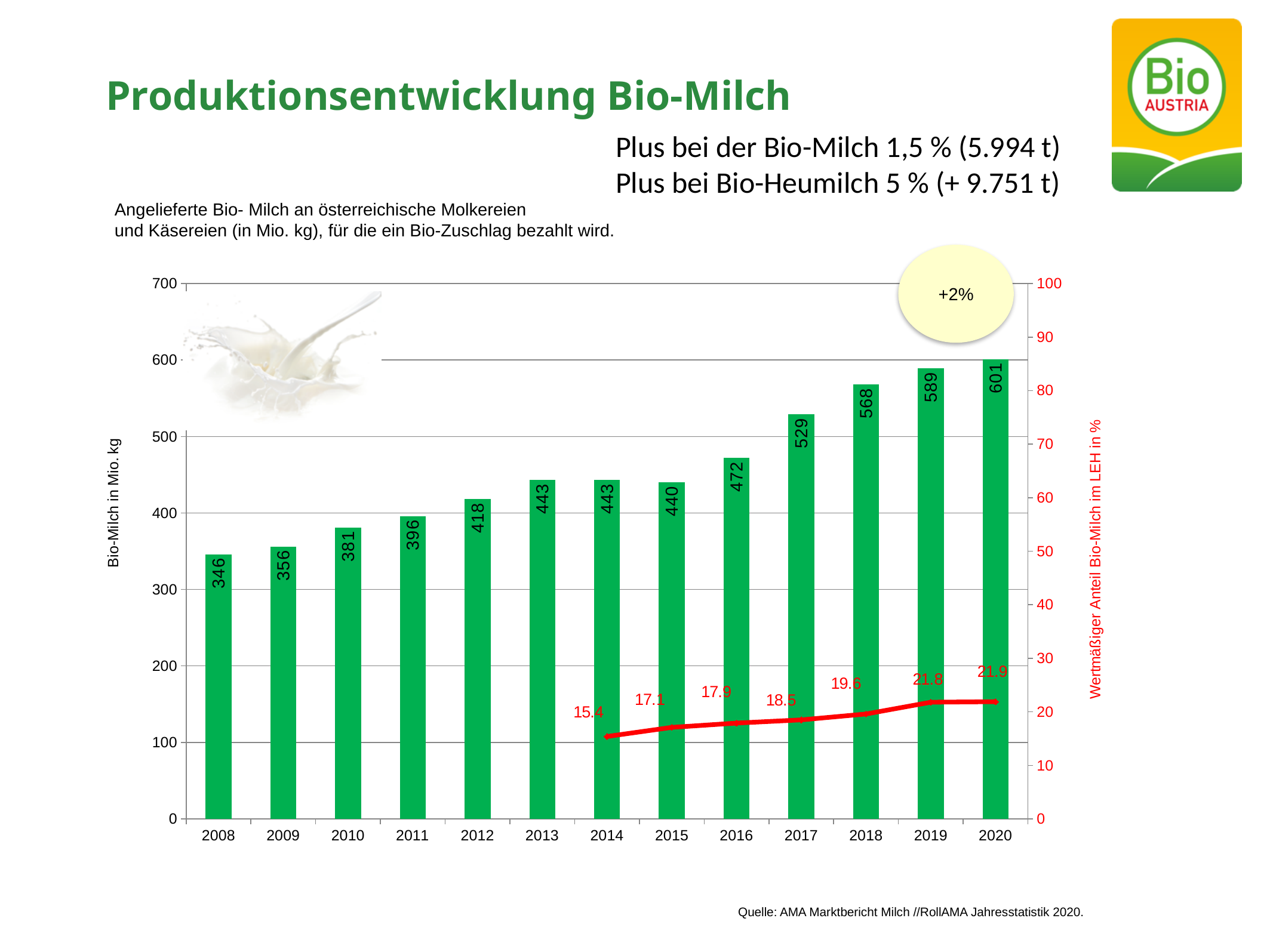
By how much did the Bio-Milch value in Mio. kg increase from 2008 to 2020? 255 Do the Bio-Milch values generally rise or fall from 2008 to 2020? rise What is the Wertmäßiger Anteil Bio-Milch im LEH in % for 2014? 15.4 How many years are shown on the x axis of the chart? 13 Which year has the highest Bio-Milch value in Mio. kg? 2020 What is the Wertmäßiger Anteil Bio-Milch im LEH in % for 2019? 21.8 Which year has the lowest Bio-Milch value in Mio. kg? 2008 What is the difference between the Bio-Milch values for 2019 and 2020? 12 What value is shown for Bio-Milch in 2008? 346 Which year has the larger Bio-Milch value, 2014 or 2015? 2014 What kind of chart is used to show the Bio-Milch values in Mio. kg? bar chart What was the Bio-Milch delivery in Mio. kg in 2020? 601